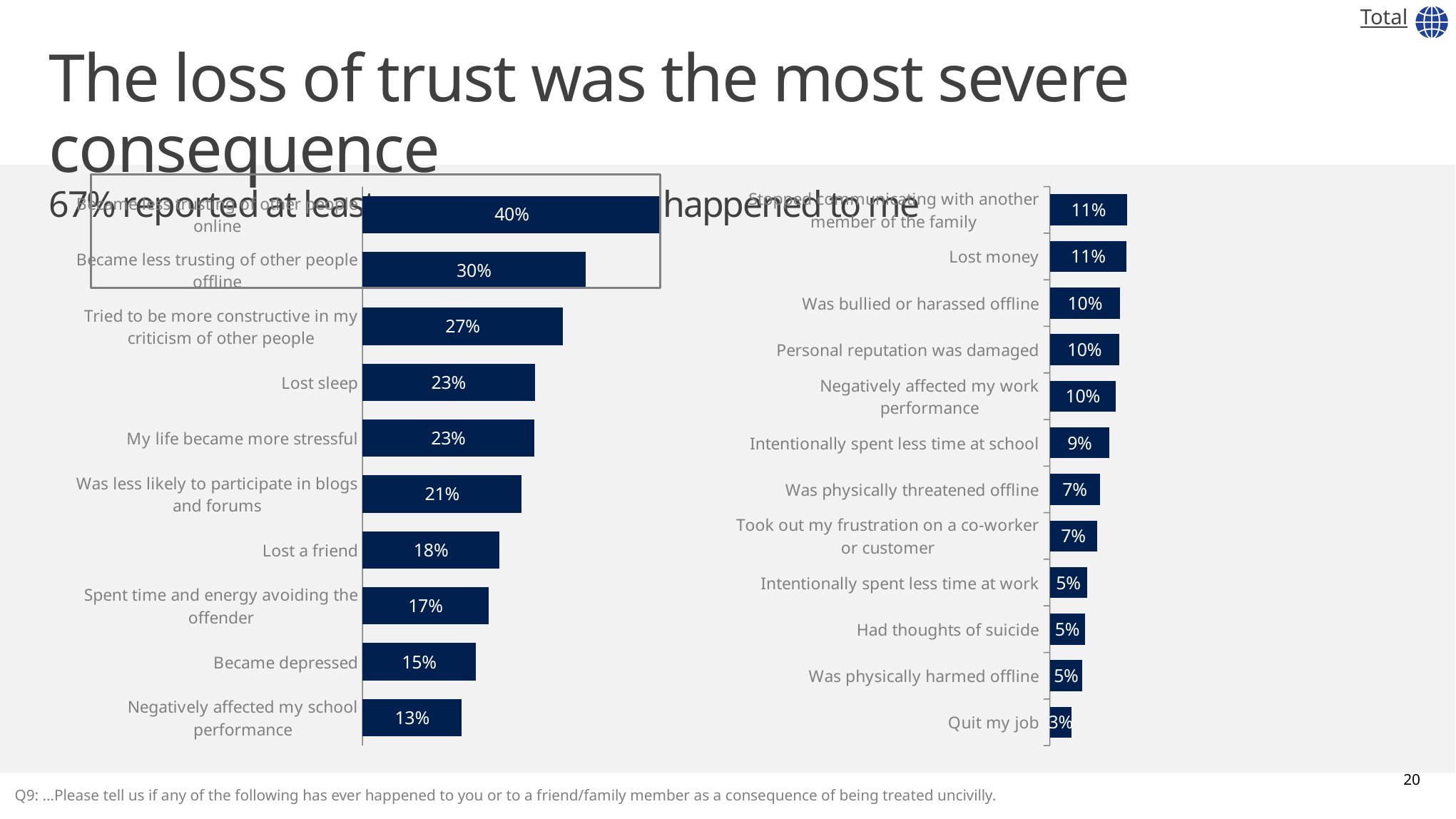
In the left chart, which is larger: 'Tried to be more constructive in my criticism of other people' or 'Spent time and energy avoiding the offender'? Tried to be more constructive in my criticism of other people What type of chart is the left chart? Bar chart How many categories does the right chart show? 12 In the left chart, which category has the lowest value? Negatively affected my school performance How many categories does the left chart show? 10 In the left chart, what is the difference between 'Became less trusting of other people offline' and 'Lost a friend'? 12% In the right chart, which category has the lowest value? Quit my job In the left chart, what is the value for 'Became depressed'? 15% In the left chart, what is the value for 'Lost sleep'? 23% In the right chart, what is the difference between 'Was bullied or harassed offline' and 'Had thoughts of suicide'? 5% In the right chart, what is the value for 'Quit my job'? 3% In the right chart, what is the value for 'Lost money'? 11%